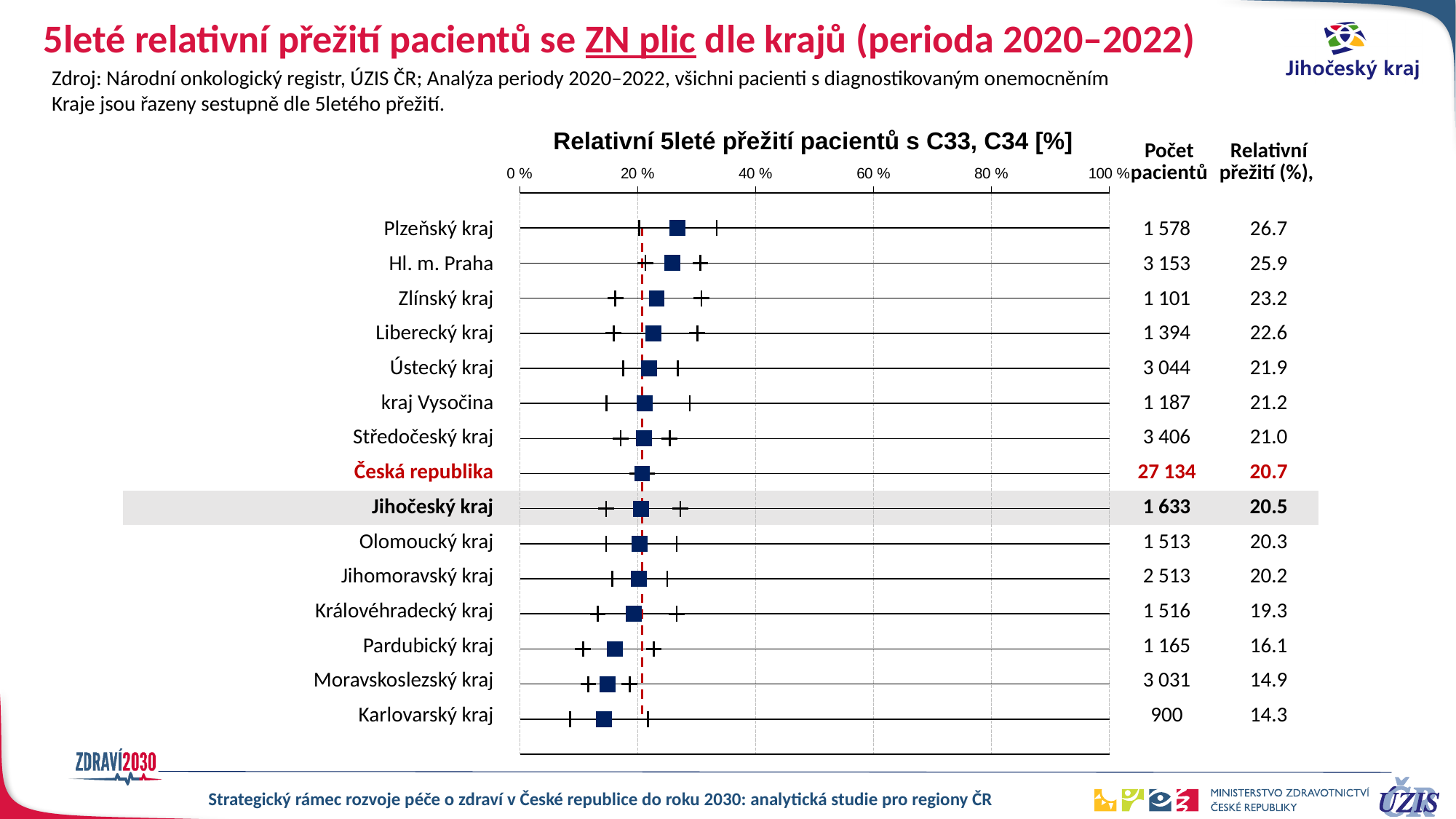
How many patients are listed for Moravskoslezský kraj? 3 031 What is the relative 5-year survival (%) for Jihočeský kraj? 20.5 How many rows (regions including Česká republika) are plotted in the chart? 15 Which region has the highest relative 5-year survival? Plzeňský kraj Which region has the lowest relative 5-year survival? Karlovarský kraj Is the relative 5-year survival for Pardubický kraj greater or less than 20 %? less What kind of chart is shown? Dot plot with error bars (forest plot) How many patients (Počet pacientů) are listed for Česká republika? 27 134 What is the difference in relative 5-year survival between Hl. m. Praha and Jihočeský kraj? 5.4 Do the relative survival values rise or fall going from the top row to the bottom row? fall What is the difference in relative 5-year survival between Plzeňský kraj and Karlovarský kraj? 12.4 Which has the higher relative 5-year survival, Zlínský kraj or Liberecký kraj? Zlínský kraj